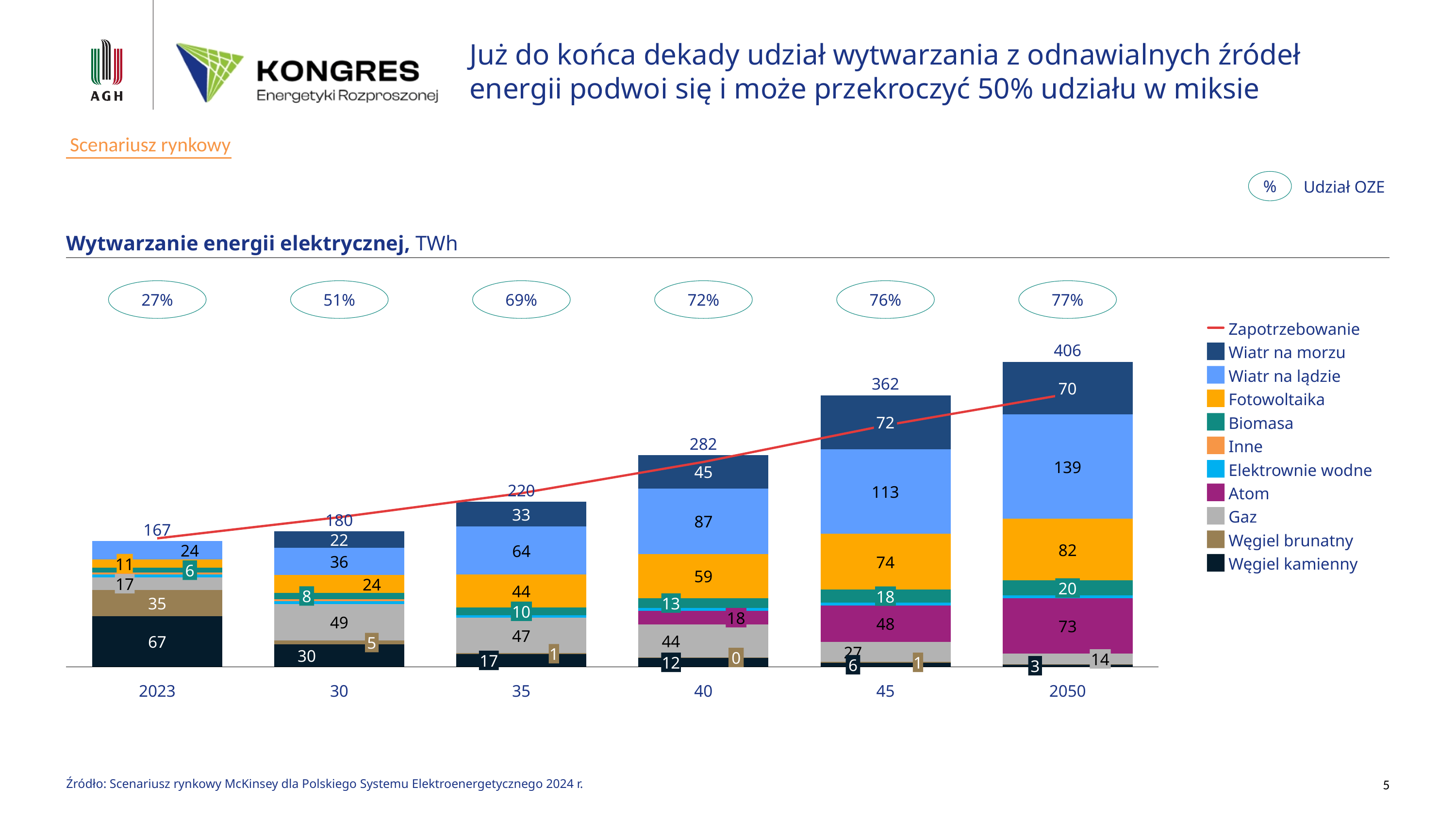
What is the value for Węgiel kamienny in 2023? 67 What is the total electricity generation (TWh) shown for 2050? 406 Which year has the lowest total electricity generation? 2023 Which year has the highest total electricity generation? 2050 What is the value for Atom in 2050? 73 Which is larger in 2040: Fotowoltaika or Gaz? Fotowoltaika What is the difference between the total generation in 2045 and in 2040? 80 Does total electricity generation rise or fall from 2023 to 2050? Rises How many series does the legend list? 11 What is the value for Wiatr na lądzie in 2045? 113 What type of chart is shown on the slide? Stacked bar chart What is the Udział OZE percentage shown for 2035? 69%